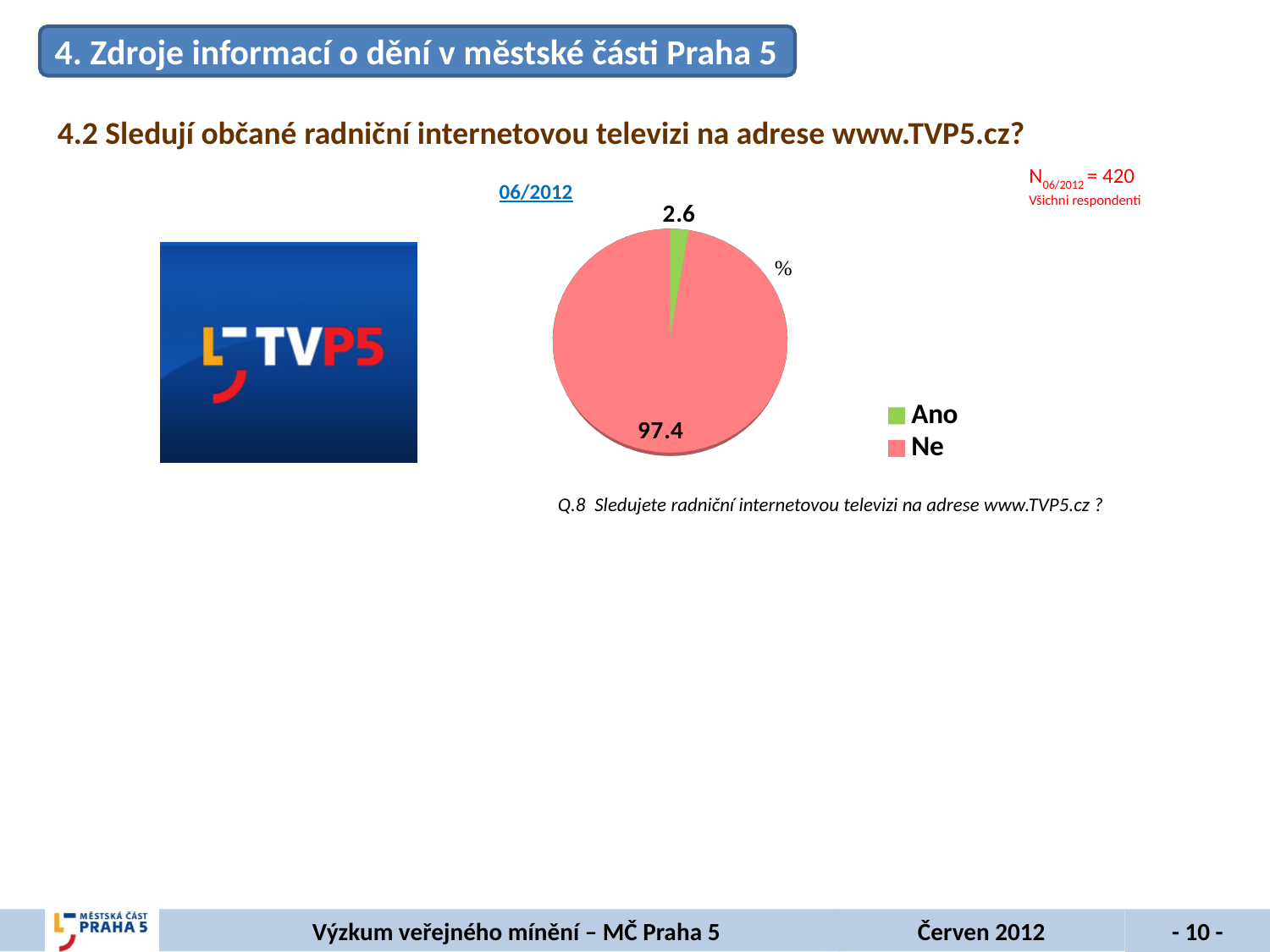
What colour is the Ano slice in the pie chart? green Which is larger, the value for Ano or the value for Ne? Ne What is the value for Ne in the pie chart? 97.4 What period label is shown above the pie chart? 06/2012 What is the value for Ano in the pie chart? 2.6 What is the difference between the values for Ne and Ano? 94.8 How many entries does the legend list? 2 What share of the pie does the Ne slice represent? 97.4% How many slices does the pie chart have? 2 What kind of chart is shown on the slide? pie chart Which category has the largest share of the pie? Ne Which category has the smallest share of the pie? Ano